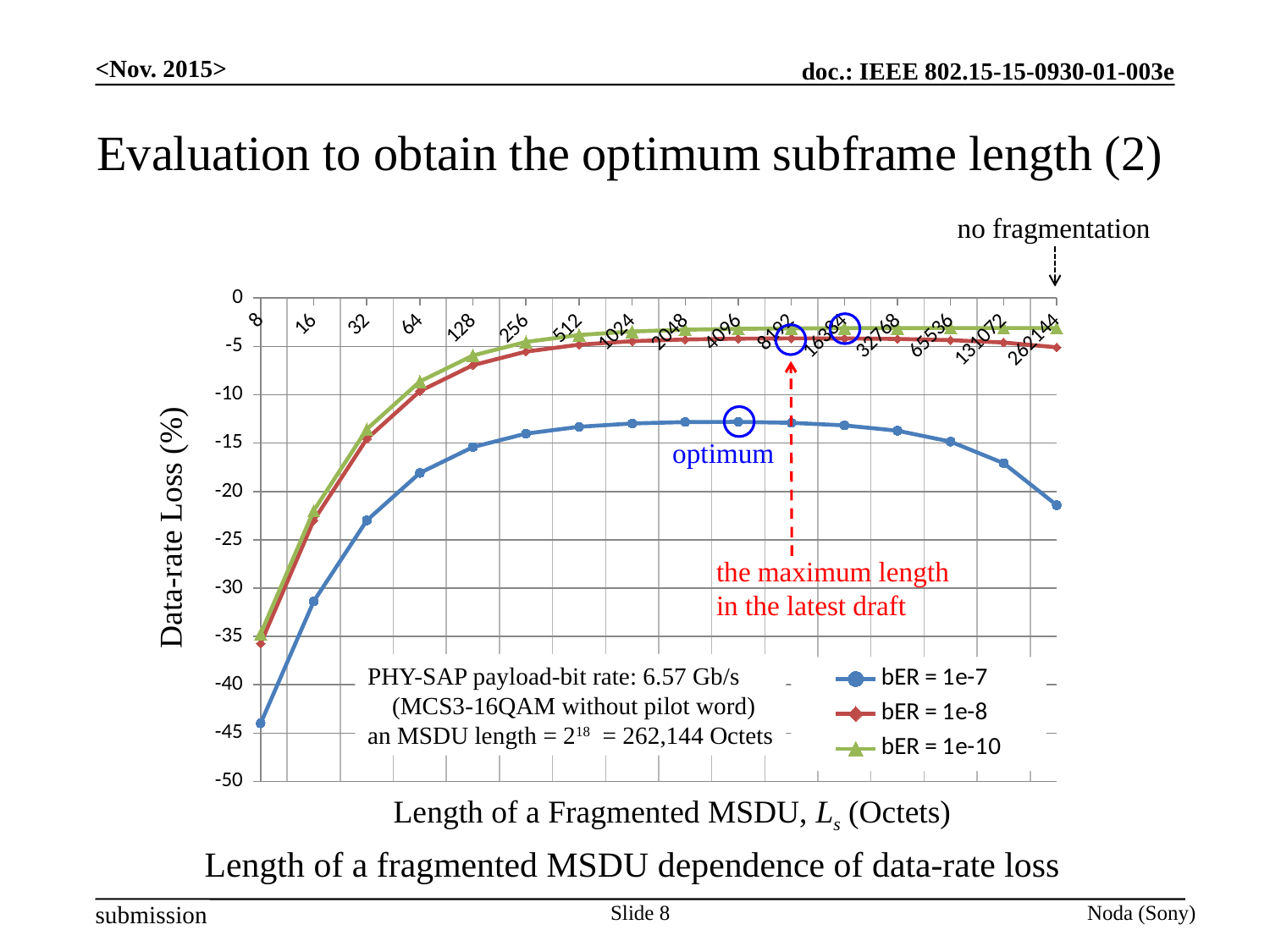
Is the value for bER = 1e-8 at a length of 32 greater or less than -10? less At a length of 262144, which is larger: the value for bER = 1e-7 or the value for bER = 1e-8? bER = 1e-8 How many series does the legend list? 3 Is the value for bER = 1e-7 at a length of 4096 greater or less than -15? greater How many points are plotted along the x axis for each series? 16 Is the value for bER = 1e-7 at a length of 8 greater or less than -40? less What is the title of the y axis? Data-rate Loss (%) At a length of 8, which series has the lowest data-rate loss value? bER = 1e-7 Does the bER = 1e-7 series rise or fall as the length increases from 8 to 4096? rise What kind of chart is shown on the slide? line chart What are the three legend entries? bER = 1e-7, bER = 1e-8, bER = 1e-10